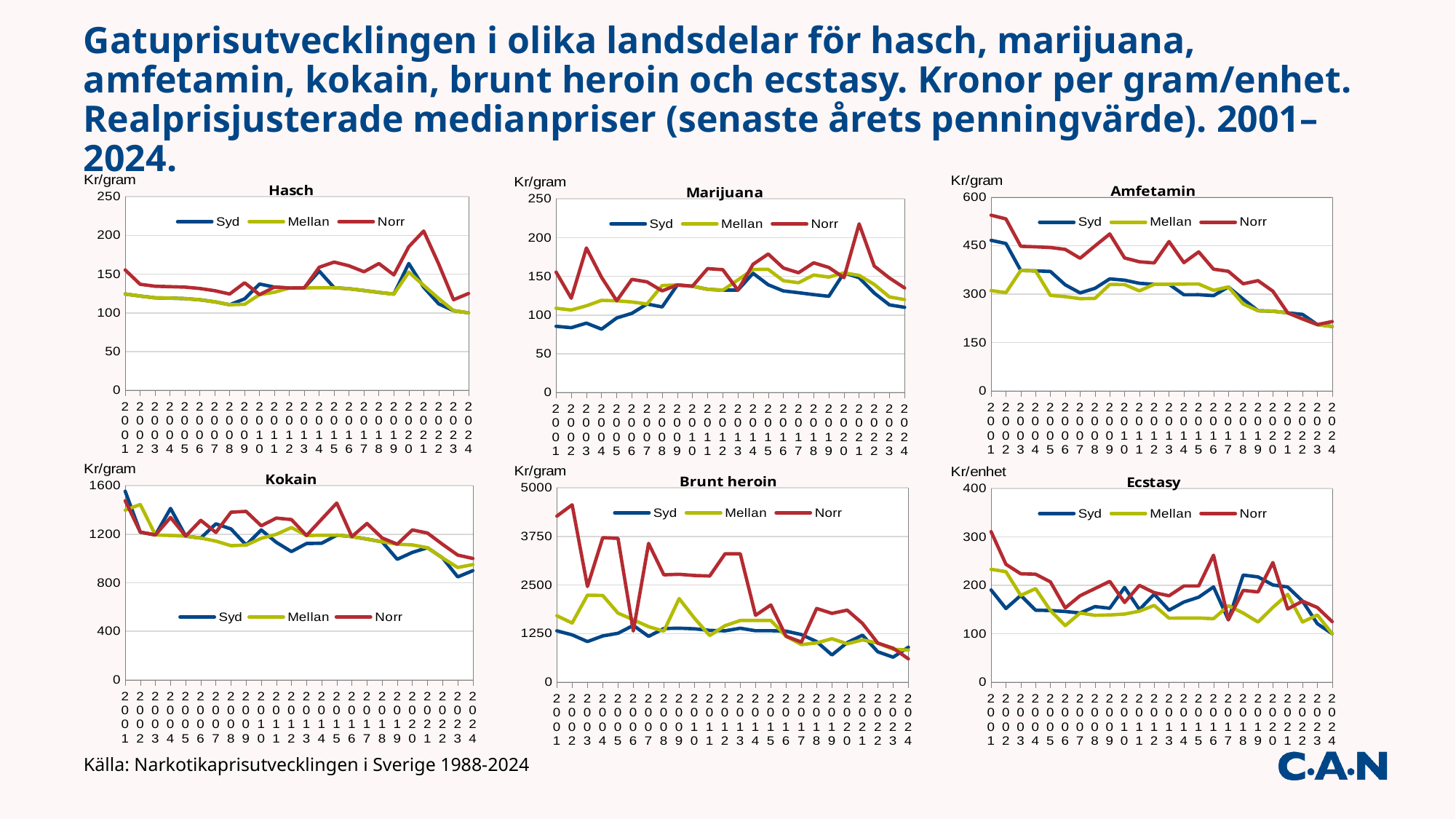
How many years are plotted along the x axis of the Kokain chart? 24 In the Hasch chart, is the value for Norr in 2021 greater or less than 150? greater In the Amfetamin chart, is the value for Norr in 2001 greater or less than 450? greater In the Brunt heroin chart, is the value for Norr in 2002 greater or less than 3750? greater In the Amfetamin chart, which is larger in 2001, Norr or Syd? Norr How many charts are shown on the slide? 6 What is the y-axis label of the Ecstasy chart? Kr/enhet In the Amfetamin chart, does the Norr series rise or fall overall from 2001 to 2024? fall What kind of chart is the Hasch chart? Line chart How many series does the legend of the Marijuana chart list? 3